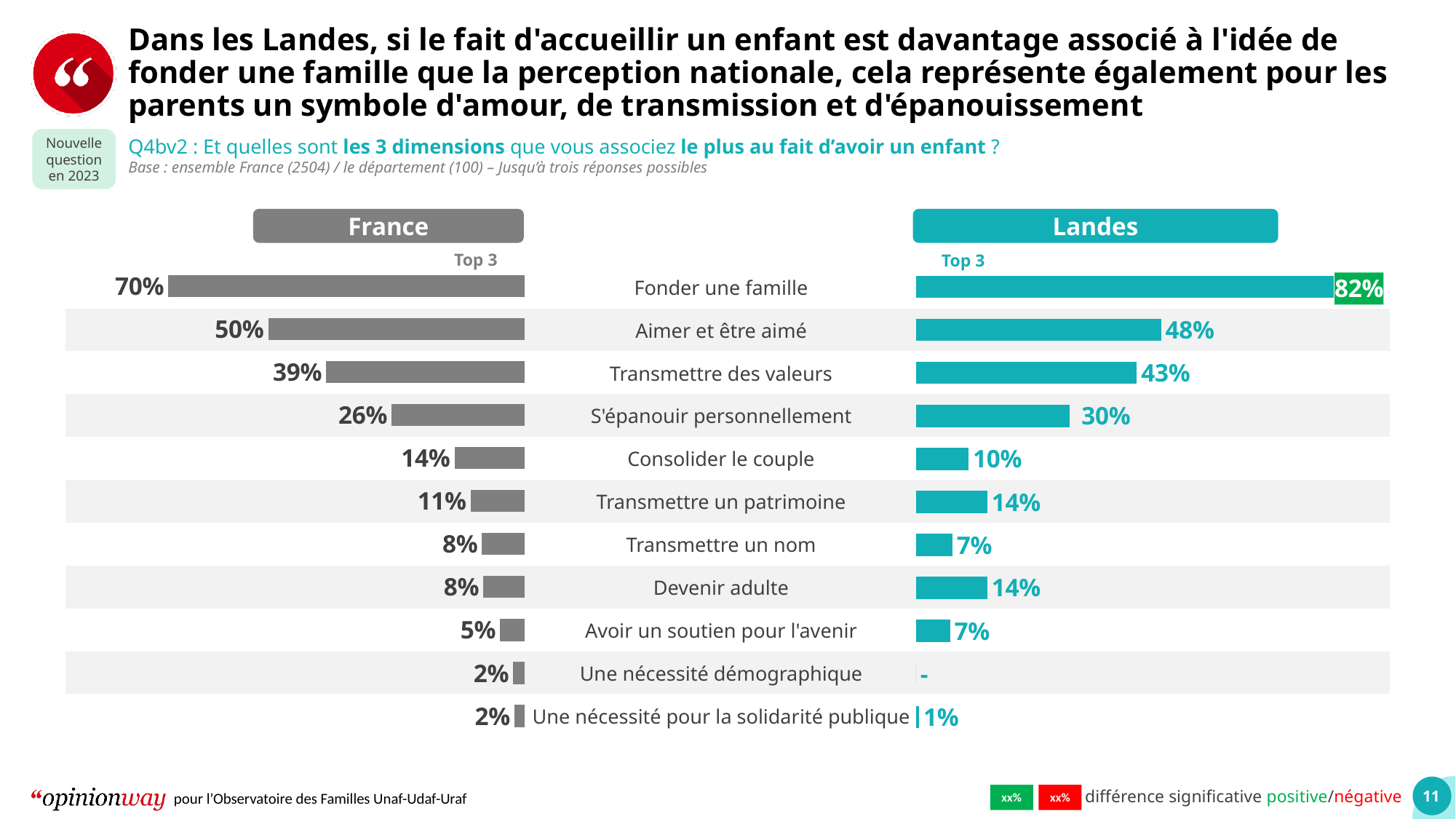
What is the difference between the Landes and France values for "Fonder une famille"? 12 points In the France chart, which category has the highest value? Fonder une famille In the France chart, what is the value for "Fonder une famille"? 70% In the France chart, what is the difference between "Aimer et être aimé" and "Transmettre des valeurs"? 11 points In the Landes chart, which category has the lowest value among those with a printed percentage? Une nécessité pour la solidarité publique In the Landes chart, what is the value for "Transmettre des valeurs"? 43% For "Devenir adulte", which is larger: the France value or the Landes value? Landes For "Aimer et être aimé", which is larger: the France value or the Landes value? France What kind of chart is used on this slide? Bar chart What colour are the bars in the Landes chart? Teal How many categories are listed in the charts? 11 In the Landes chart, what is the value for "Consolider le couple"? 10%